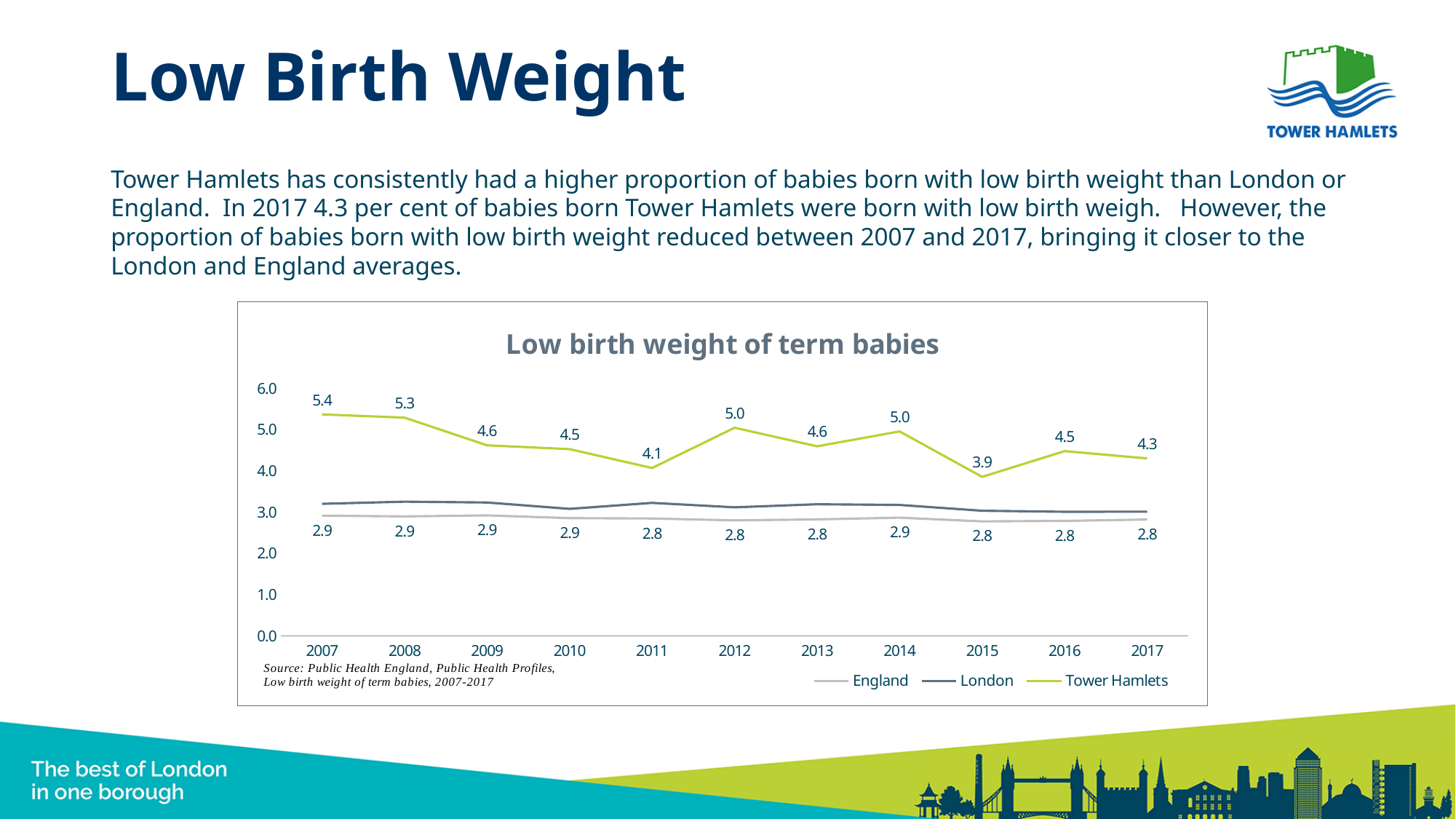
Which year has the higher Tower Hamlets value, 2012 or 2013? 2012 How many series does the legend list? 3 What is the title of the chart? Low birth weight of term babies Is the London value for 2017 greater or less than 4.0? less How many years are shown on the x axis? 11 What is the difference between the Tower Hamlets values for 2007 and 2017? 1.1 What kind of chart is shown? line chart What is the Tower Hamlets value for 2007? 5.4 What is the England value for 2011? 2.8 In which year was the Tower Hamlets value highest? 2007 What is the Tower Hamlets value for 2017? 4.3 In which year was the Tower Hamlets value lowest? 2015